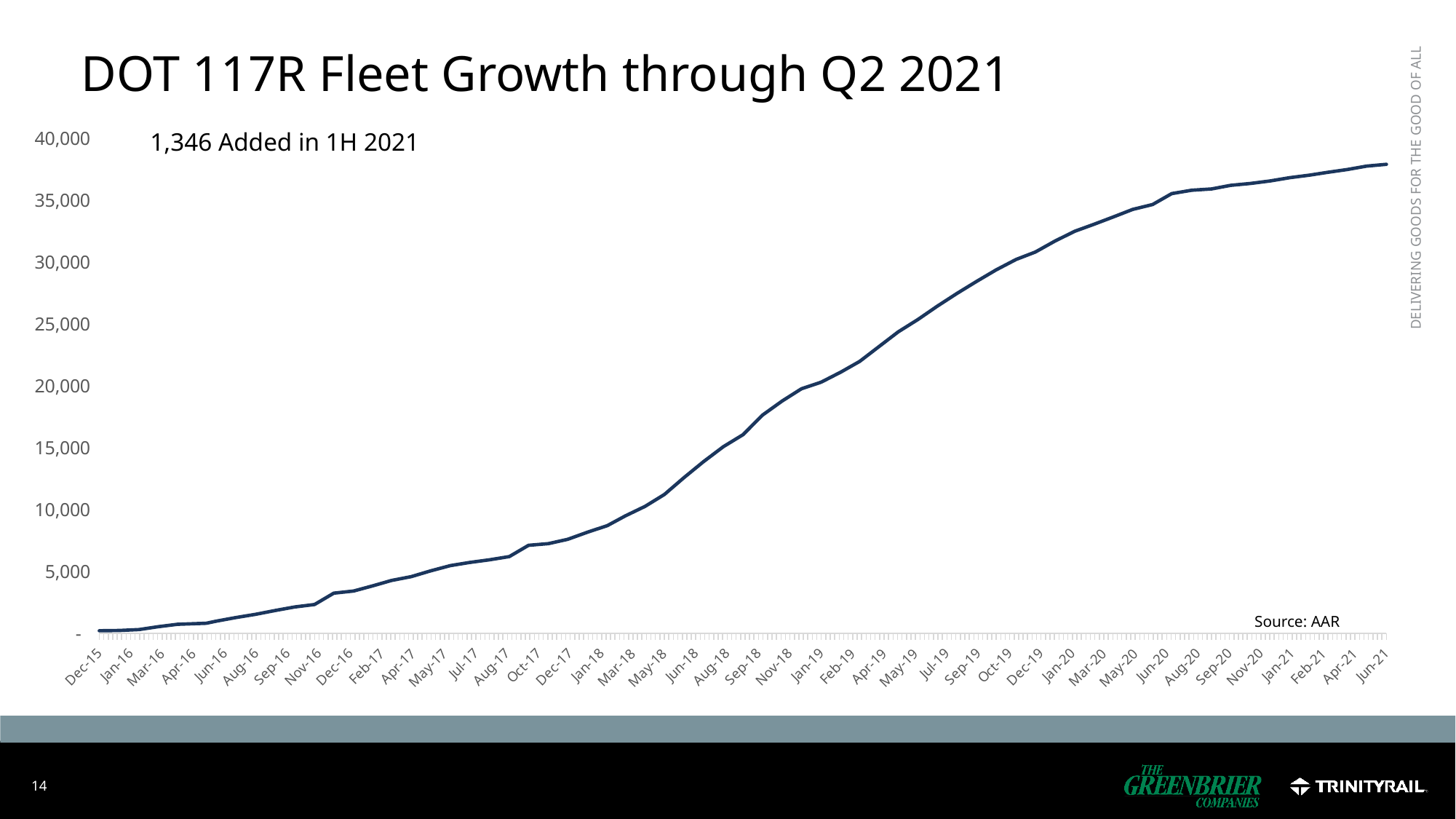
Is the value for Jun-21 greater or less than 35,000? greater What is the title of the chart? DOT 117R Fleet Growth through Q2 2021 Is the value for Jun-18 greater or less than 15,000? less Which month has the highest value on the chart? Jun-21 Is the value for Dec-15 greater or less than 5,000? less Do the values rise or fall from Dec-15 to Jun-21? Rise What source is cited for the chart data? AAR Which is larger, the value for Jan-20 or the value for Jan-18? Jan-20 Which month has the lowest value on the chart? Dec-15 What kind of chart is shown on the slide? Line chart